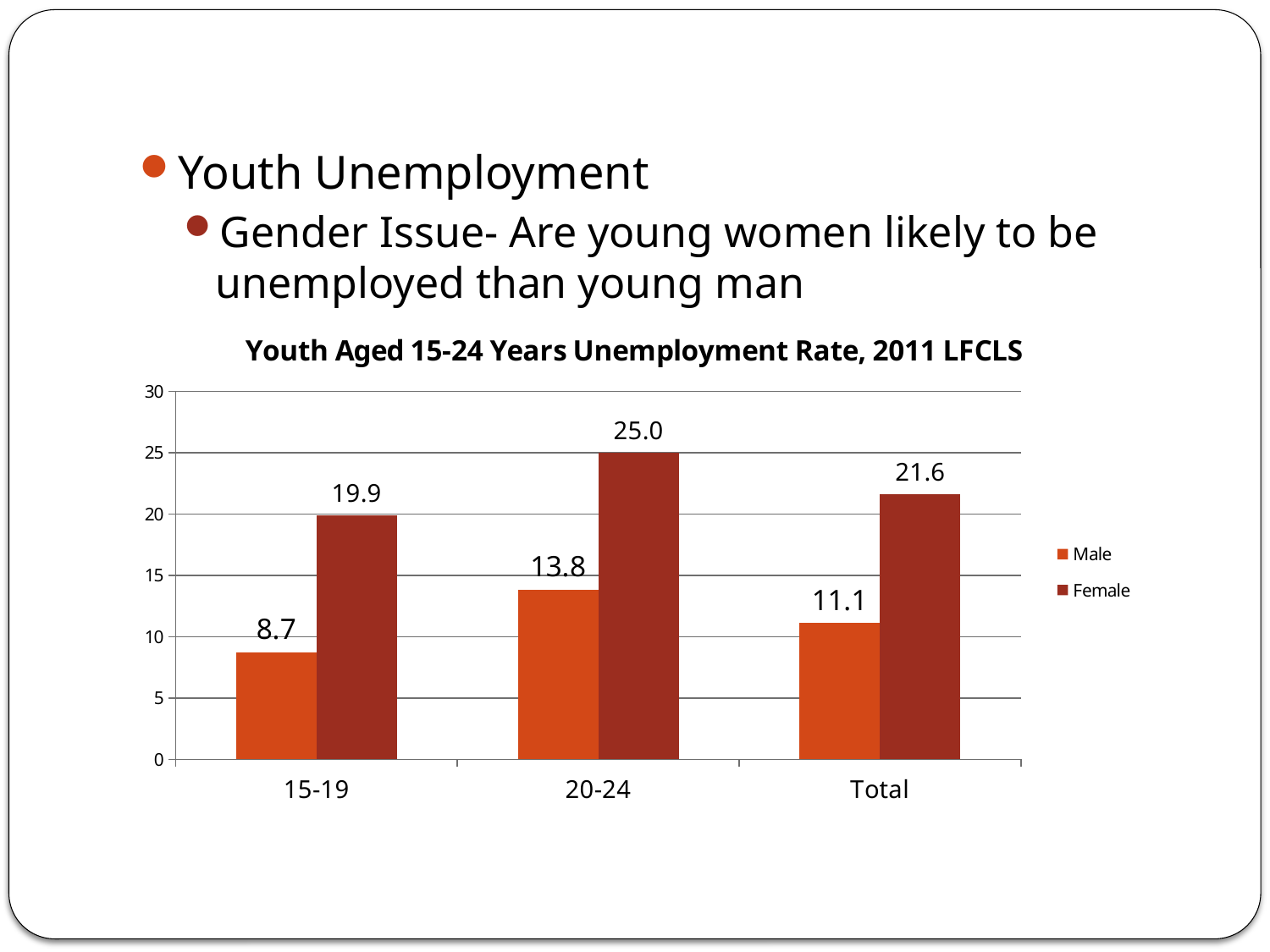
How many series does the legend list? 2 What is the title of the chart? Youth Aged 15-24 Years Unemployment Rate, 2011 LFCLS What kind of chart is shown on the slide? Bar chart Which category has the lowest Male unemployment rate? 15-19 Which is larger, the Male rate for 20-24 or the Male rate for Total? Male rate for 20-24 How many categories are shown on the x axis? 3 What is the Female value for the Total category? 21.6 What is the Female unemployment rate for the 20-24 age group? 25.0 What is the Male unemployment rate for the 15-19 age group? 8.7 Which category has the highest Female unemployment rate? 20-24 What is the difference between the Female and Male rates for the 15-19 age group? 11.2 What is the difference between the Female rates for 20-24 and 15-19? 5.1